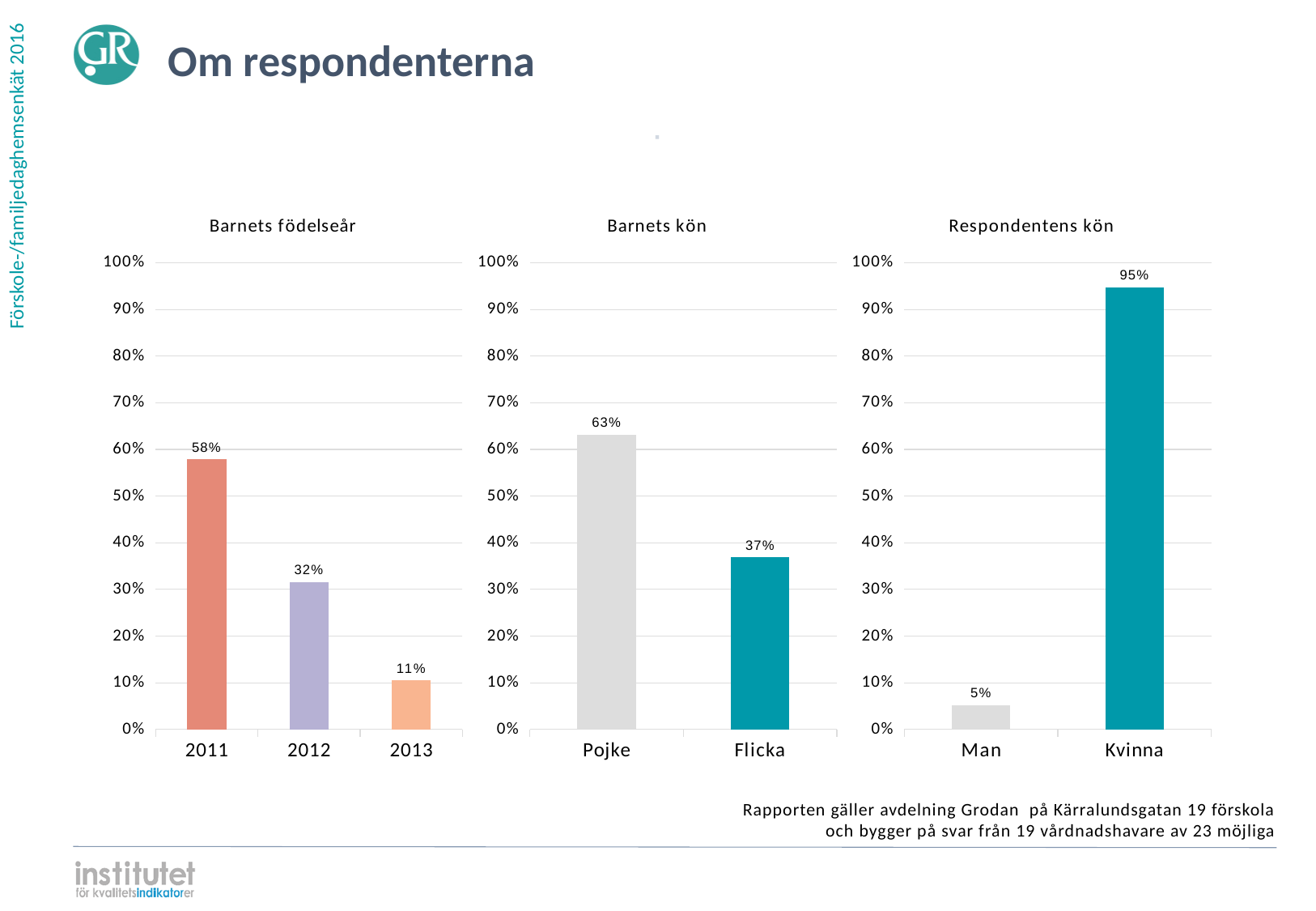
In the 'Barnets kön' chart, what is the value for Flicka? 37% In the 'Respondentens kön' chart, what is the value for Man? 5% In the 'Barnets födelseår' chart, do the values rise or fall from 2011 to 2013? fall In the 'Barnets kön' chart, what is the difference between Pojke and Flicka? 26% In the 'Barnets födelseår' chart, which birth year has the lowest value? 2013 In the 'Respondentens kön' chart, which category has the highest value? Kvinna In the 'Barnets födelseår' chart, what is the value for 2011? 58% In the 'Barnets kön' chart, which category is higher, Pojke or Flicka? Pojke In the 'Barnets födelseår' chart, how many categories are shown? 3 In the 'Barnets födelseår' chart, what is the difference between the values for 2011 and 2012? 26% What kind of chart is the 'Barnets kön' chart? bar chart In the 'Respondentens kön' chart, is the value for Kvinna greater or less than 90%? greater